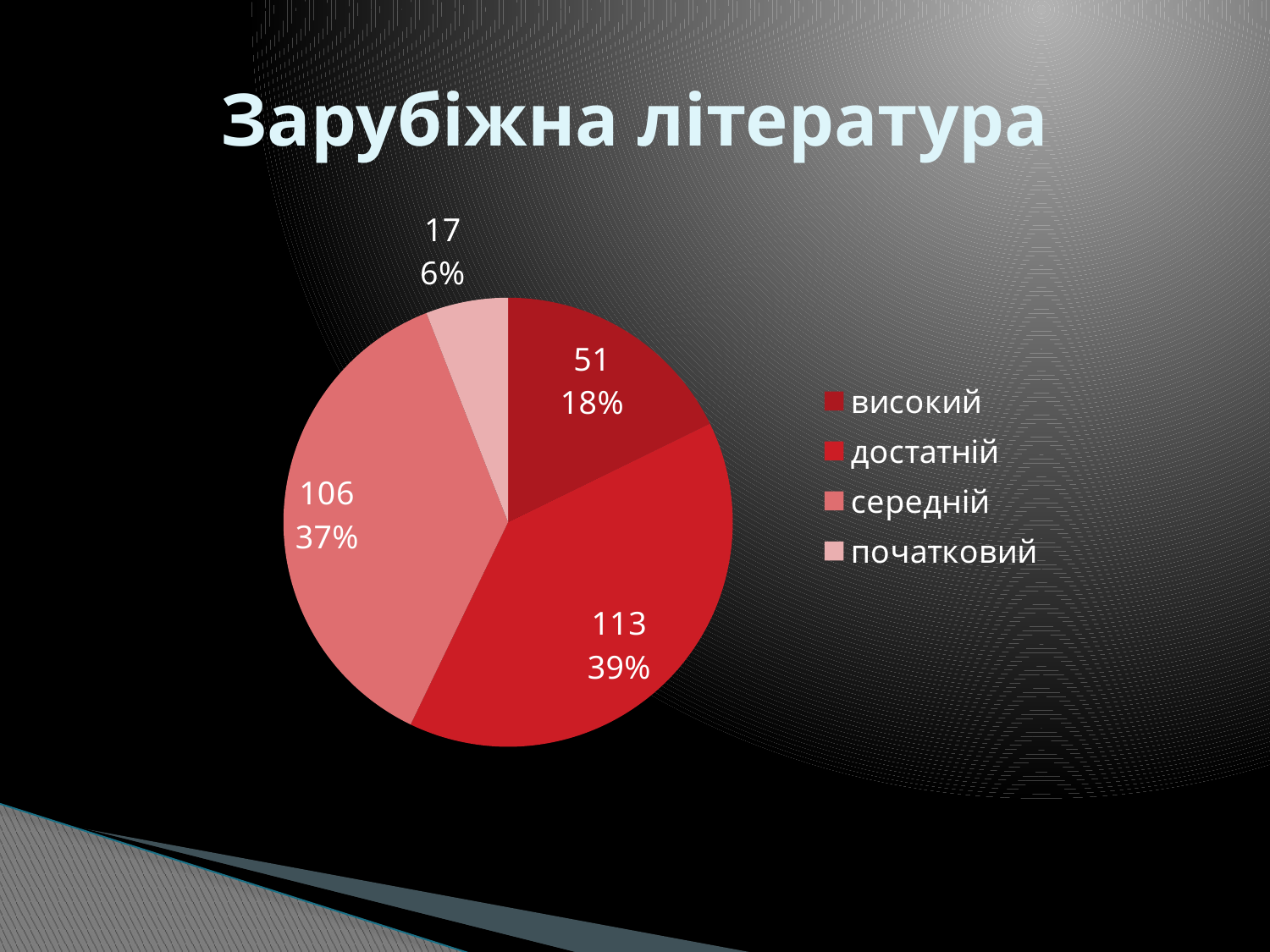
What is the difference between the values for "достатній" and "середній"? 7 Which category has the smallest slice? початковий How many categories does the pie chart have? 4 What kind of chart is shown on the slide? pie chart Which category has the largest slice? достатній What is the value for the "високий" slice? 51 What percentage share does the "середній" slice have? 37% What is the title of the slide containing the chart? Зарубіжна література What is the value for the "достатній" slice? 113 What is the difference between the values for "високий" and "початковий"? 34 Which is larger, the value for "високий" or the value for "початковий"? високий What percentage share does the "початковий" slice have? 6%